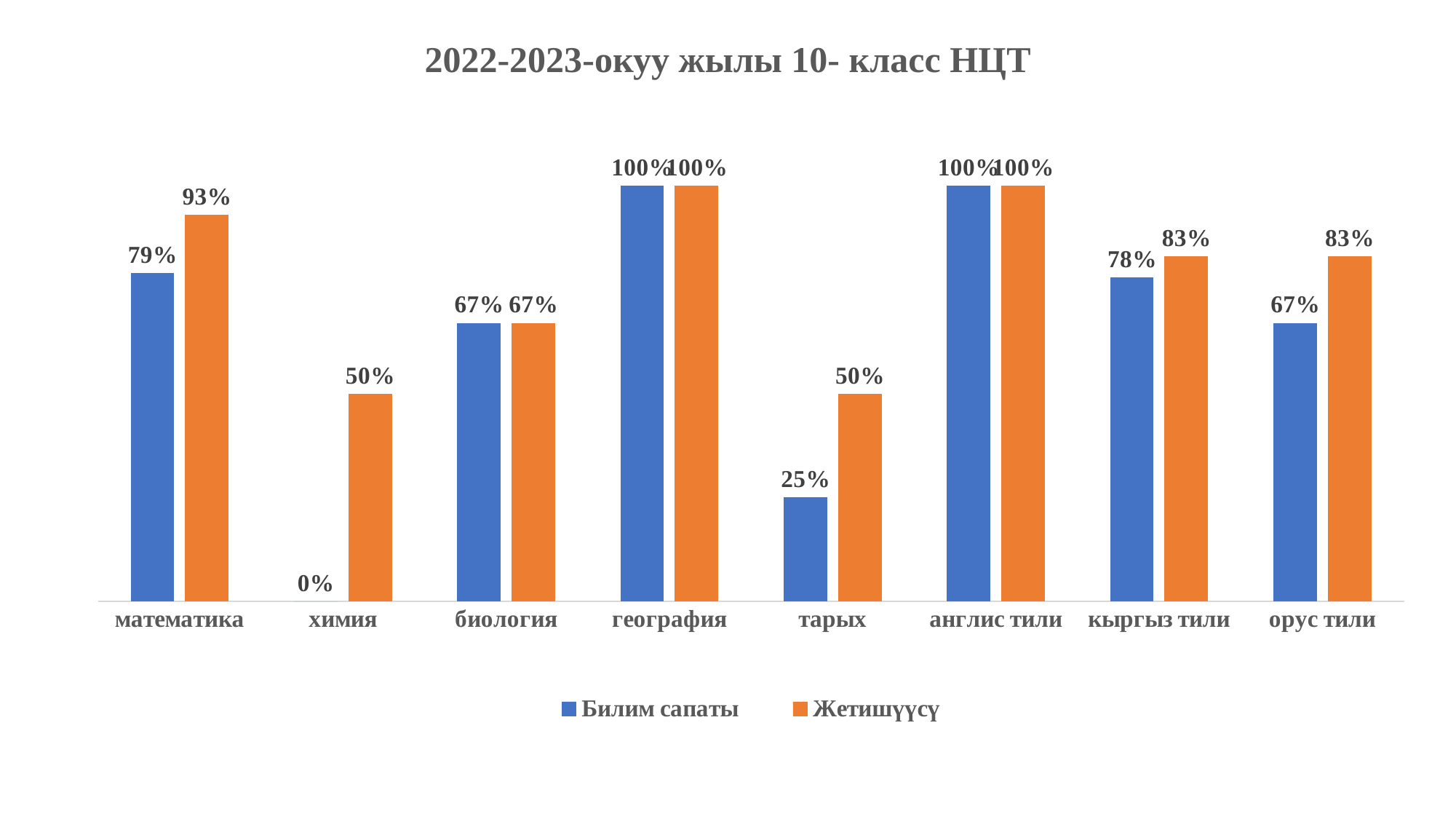
How many series does the legend list? 2 What is the difference between Жетишүүсү and Билим сапаты for математика? 14% How many categories are shown on the x axis? 8 What type of chart is shown on the slide? bar chart What is the value of Жетишүүсү for химия? 50% Which category has the lowest value for Билим сапаты? химия What is the value of Жетишүүсү for орус тили? 83% Which is larger for кыргыз тили: Билим сапаты or Жетишүүсү? Жетишүүсү What is the value of Билим сапаты for тарых? 25% What is the difference between Жетишүүсү and Билим сапаты for тарых? 25% What is the value of Билим сапаты for математика? 79%